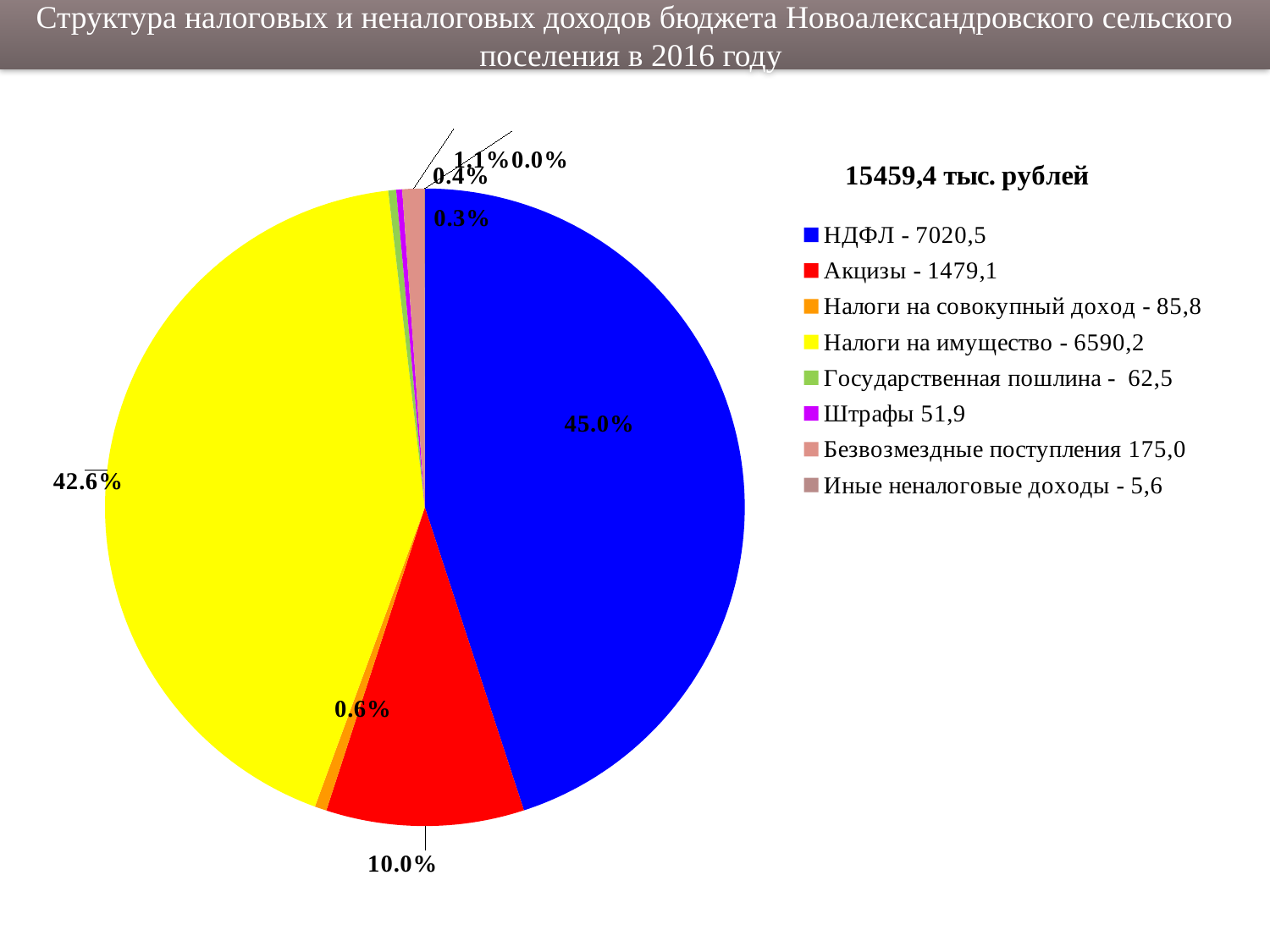
What share of the pie does Налоги на имущество account for? 42.6% What kind of chart is shown on the slide? pie chart What total amount is printed above the legend? 15459,4 тыс. рублей Which category has the largest slice of the pie? НДФЛ Which slice is larger: НДФЛ or Налоги на имущество? НДФЛ What share of the pie does НДФЛ account for? 45.0% What value is given for НДФЛ in the legend? 7020,5 What share of the pie does Акцизы account for? 10.0% How many categories does the legend list? 8 What value is given for Акцизы in the legend? 1479,1 By how many percentage points does the НДФЛ share exceed the Акцизы share? 35.0